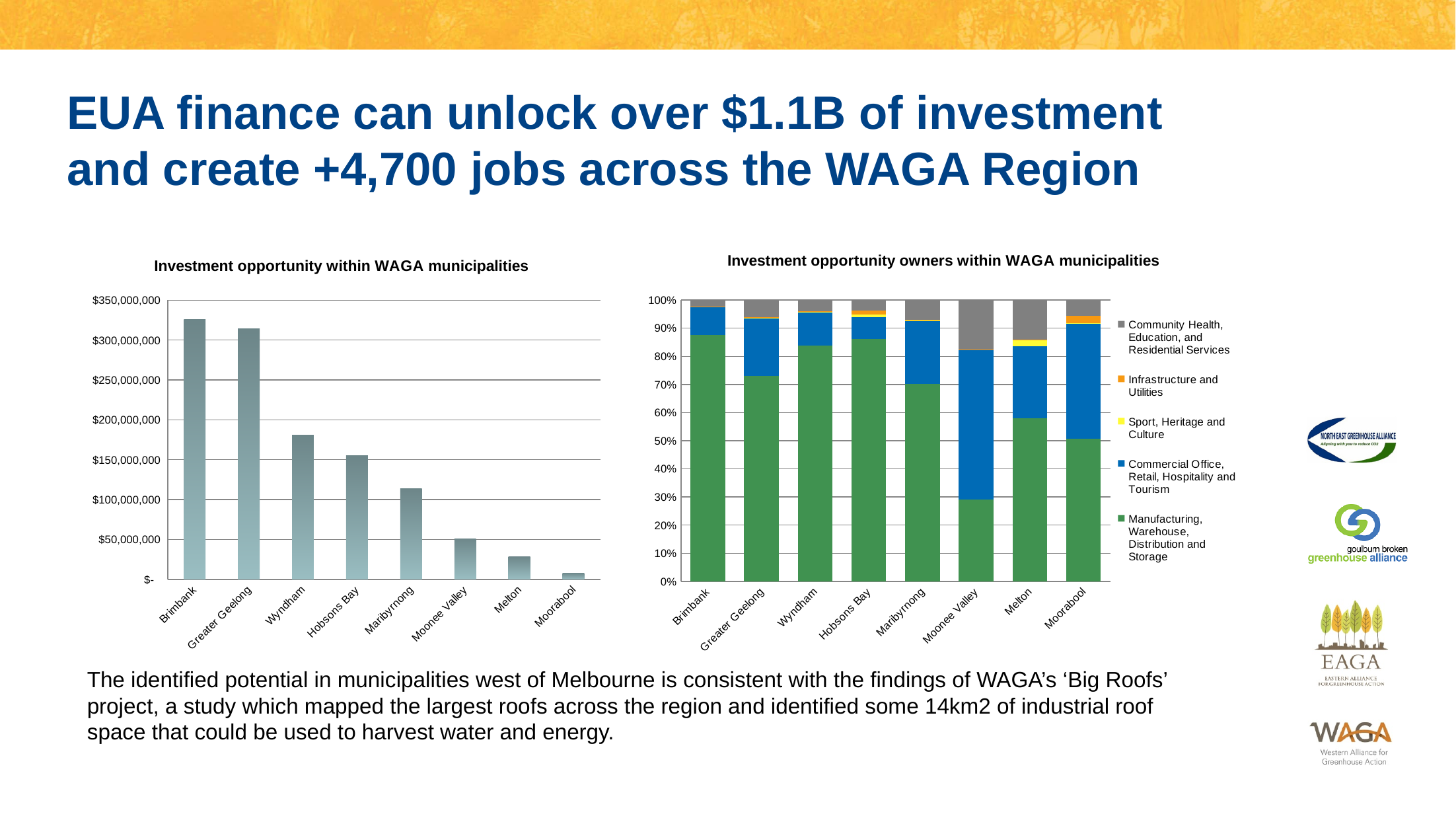
On the 'Investment opportunity owners within WAGA municipalities' chart, which municipality has the smallest share for Manufacturing, Warehouse, Distribution and Storage? Moonee Valley On the 'Investment opportunity within WAGA municipalities' chart, do the values generally rise or fall from left to right? Fall How many series does the legend of the 'Investment opportunity owners within WAGA municipalities' chart list? 5 What kind of chart is the 'Investment opportunity within WAGA municipalities' chart? Bar chart How many municipalities are shown on the 'Investment opportunity within WAGA municipalities' chart? 8 On the 'Investment opportunity within WAGA municipalities' chart, is the value for Melton greater or less than $50,000,000? less What kind of chart is the 'Investment opportunity owners within WAGA municipalities' chart? Stacked bar chart On the 'Investment opportunity within WAGA municipalities' chart, is the value for Maribyrnong greater or less than $100,000,000? greater On the 'Investment opportunity within WAGA municipalities' chart, which is larger, Wyndham or Hobsons Bay? Wyndham On the 'Investment opportunity within WAGA municipalities' chart, is the value for Brimbank greater or less than $300,000,000? greater On the 'Investment opportunity within WAGA municipalities' chart, which municipality has the lowest investment opportunity? Moorabool